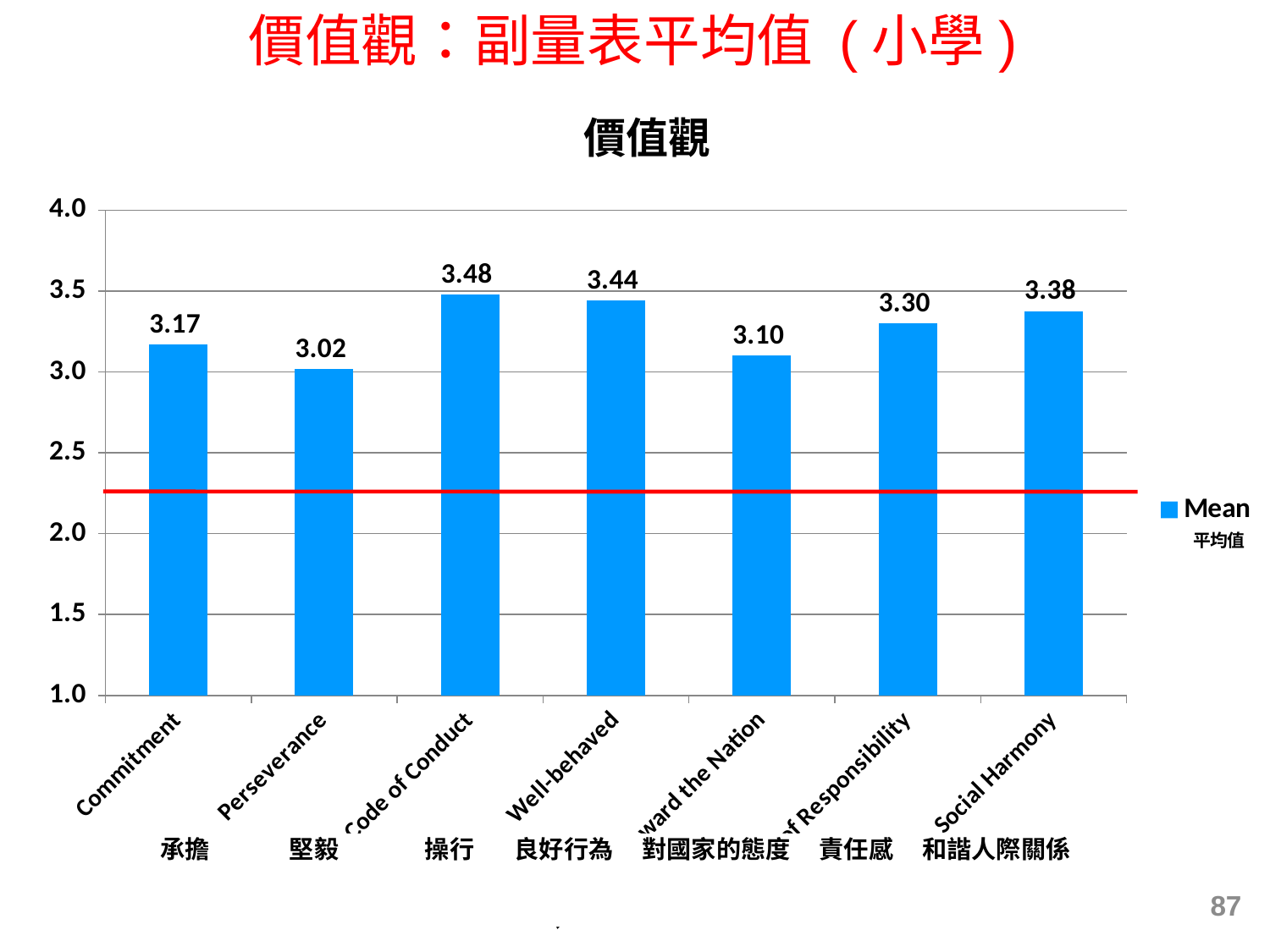
What is the mean value for Perseverance (堅毅)? 3.02 How many categories are shown in the chart? 7 What is the mean value for Commitment (承擔)? 3.17 What is the difference between the mean values for Code of Conduct (操行) and Perseverance (堅毅)? 0.46 What is the mean value for Social Harmony (和諧人際關係)? 3.38 Which has a higher mean value, Well-behaved (良好行為) or 對國家的態度 (Attitude toward the Nation)? Well-behaved (良好行為) Which category has the lowest mean value? Perseverance (堅毅) What series name does the legend show? Mean (平均值) Is the mean value for 對國家的態度 (Attitude toward the Nation) greater or less than 3.5? less Which category has the highest mean value? Code of Conduct (操行) What type of chart is shown on the slide? Bar chart What is the mean value for 責任感 (Responsibility)? 3.30